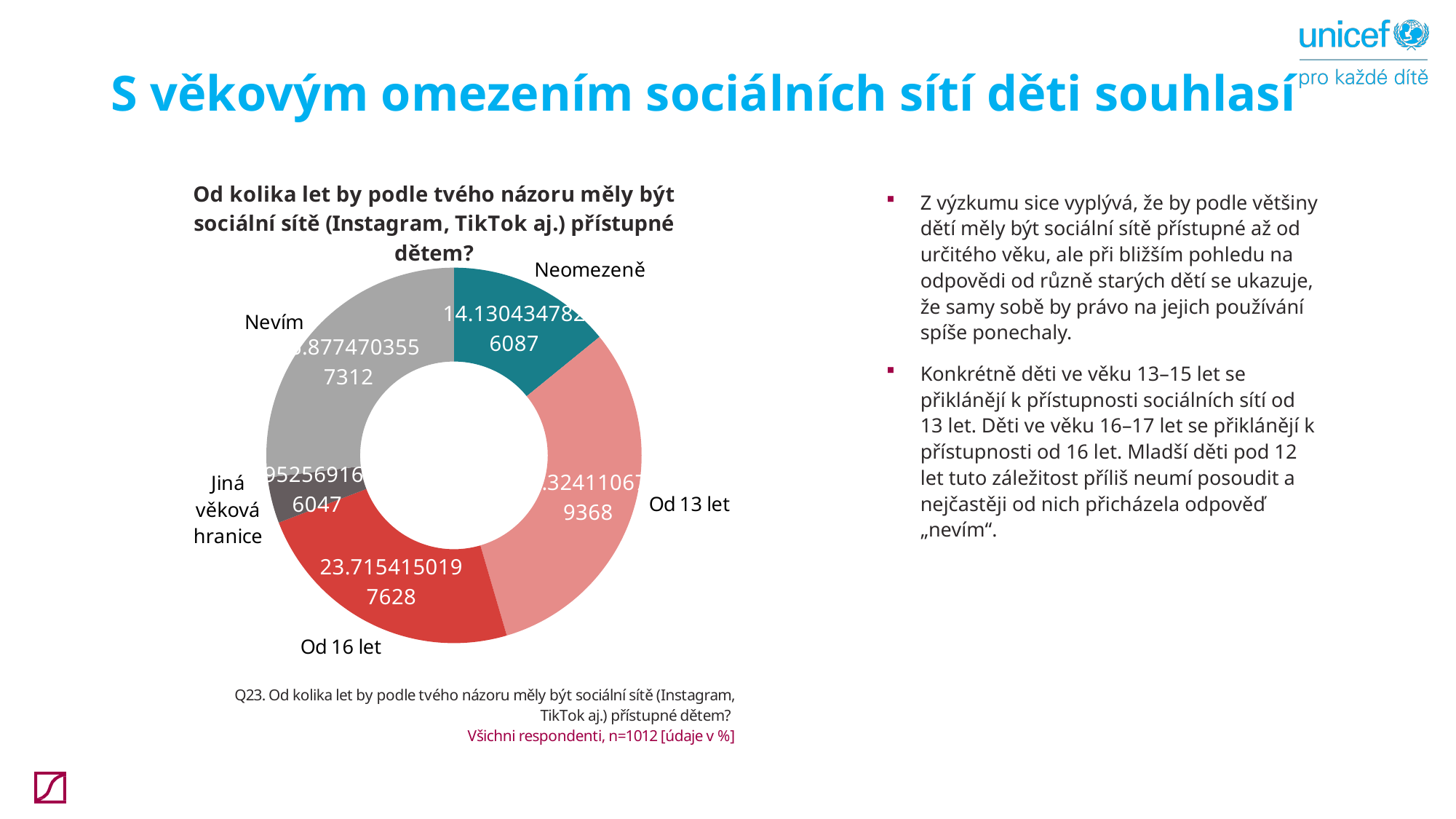
What colour is the 'Od 16 let' slice? Red What colour is the 'Nevím' slice? Grey How many categories does the pie chart show? 5 Which slice is larger, 'Nevím' or 'Jiná věková hranice'? Nevím What is the value shown for 'Od 16 let'? 23.7154150197628 Which category has the smallest slice in the pie chart? Jiná věková hranice Which category has the largest slice in the pie chart? Od 13 let Which slice is larger, 'Od 16 let' or 'Neomezeně'? Od 16 let Which slice is larger, 'Od 13 let' or 'Od 16 let'? Od 13 let What kind of chart is shown on the slide? Pie (donut) chart